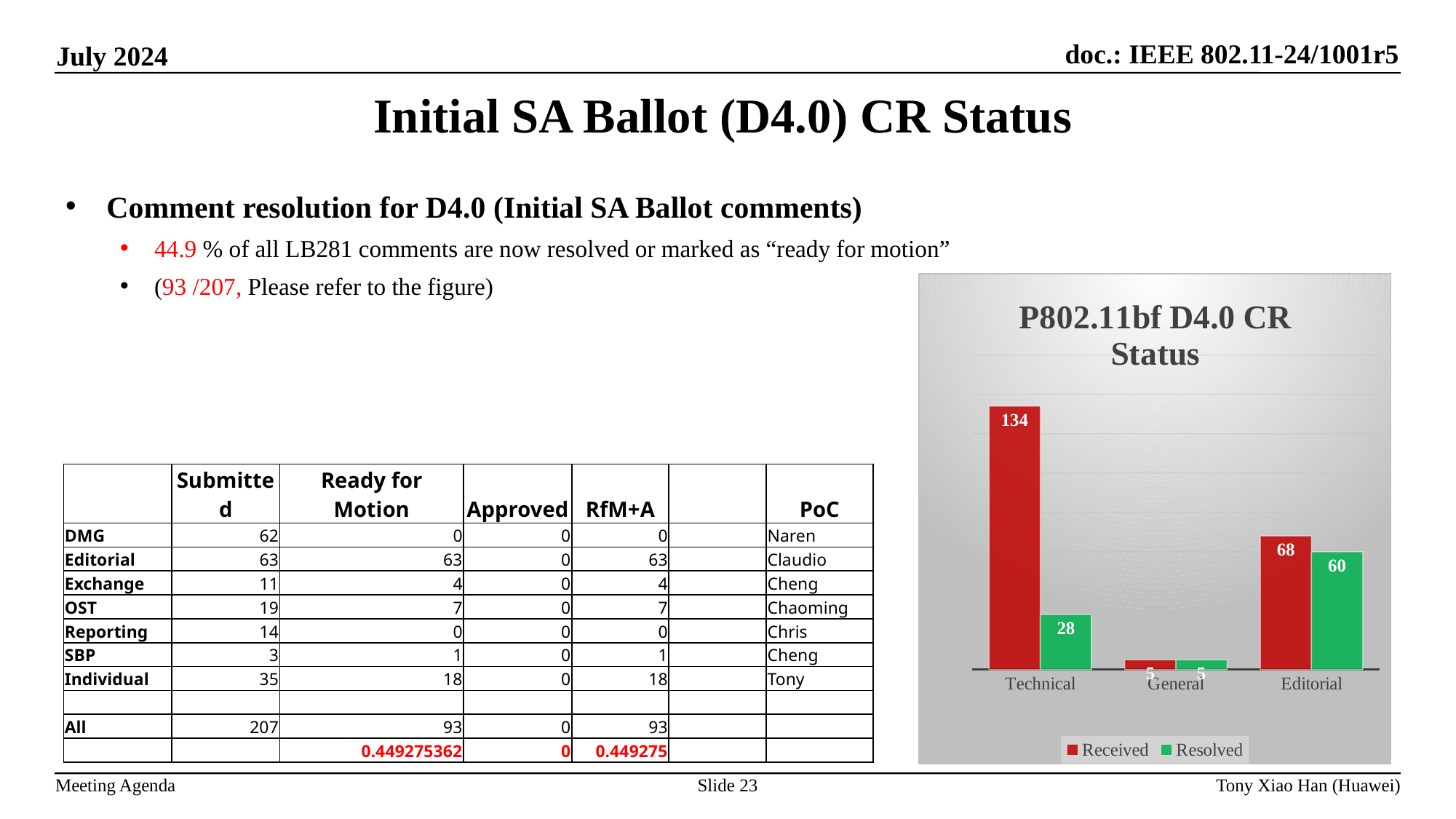
What is the title of the chart? P802.11bf D4.0 CR Status What kind of chart is shown on the slide? bar chart What is the Resolved value for Editorial? 60 What is the Received value for Technical? 134 Which category has the lowest Resolved value? General How many categories are shown on the x axis of the chart? 3 How many series does the chart legend list? 2 Which is larger, the Received value for Editorial or the Resolved value for Technical? Received value for Editorial What is the difference between Received and Resolved for Technical? 106 What is the Resolved value for Technical? 28 Which category has the highest Received value? Technical Which series is shown in red in the chart? Received